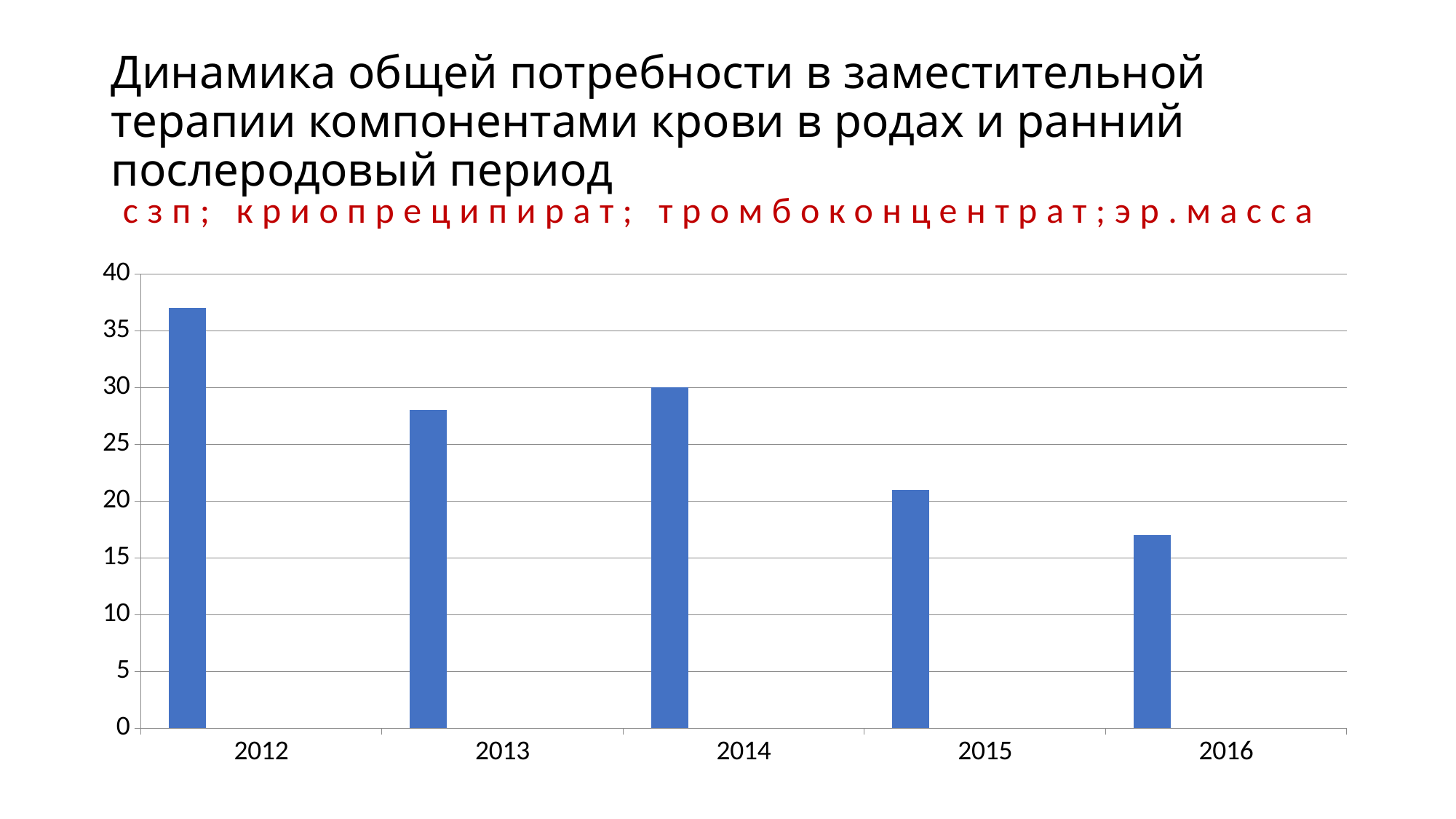
What is the value for 2014 in the chart? 30 Is the value for 2012 greater or less than 35? greater What kind of chart is shown on the slide? bar chart Is the value for 2013 greater or less than 25? greater Is the value for 2015 greater or less than 25? less Which year has the highest bar in the chart? 2012 Which is larger, the value for 2012 or the value for 2014? 2012 Overall, do the values rise or fall from 2012 to 2016? fall How many years are shown on the x axis of the chart? 5 Which is larger, the value for 2013 or the value for 2015? 2013 Which year has the lowest bar in the chart? 2016